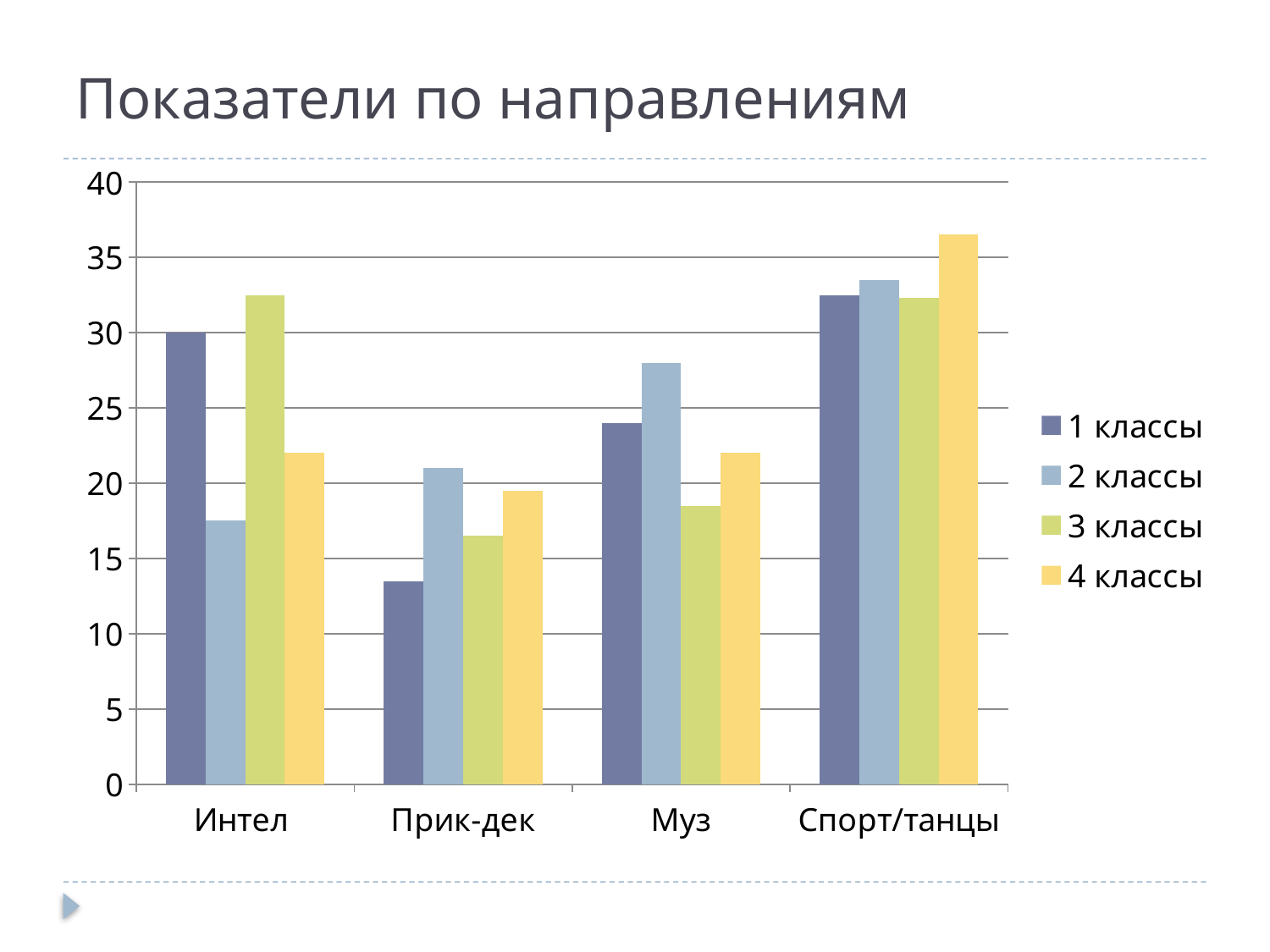
How many series does the legend list? 4 How many categories are shown on the x axis? 4 What kind of chart is shown on the slide? bar chart What is the title of the chart? Показатели по направлениям In the Прик-дек category, which series has the lowest value? 1 классы Is the value for 2 классы in Интел greater or less than 20? less For the 4 классы series, which category has the highest value? Спорт/танцы Is the value for 2 классы in Муз greater or less than 25? greater In the Муз category, which is larger: the value for 1 классы or for 3 классы? 1 классы Is the value for 1 классы in Прик-дек greater or less than 15? less In the Интел category, which series has the highest value? 3 классы